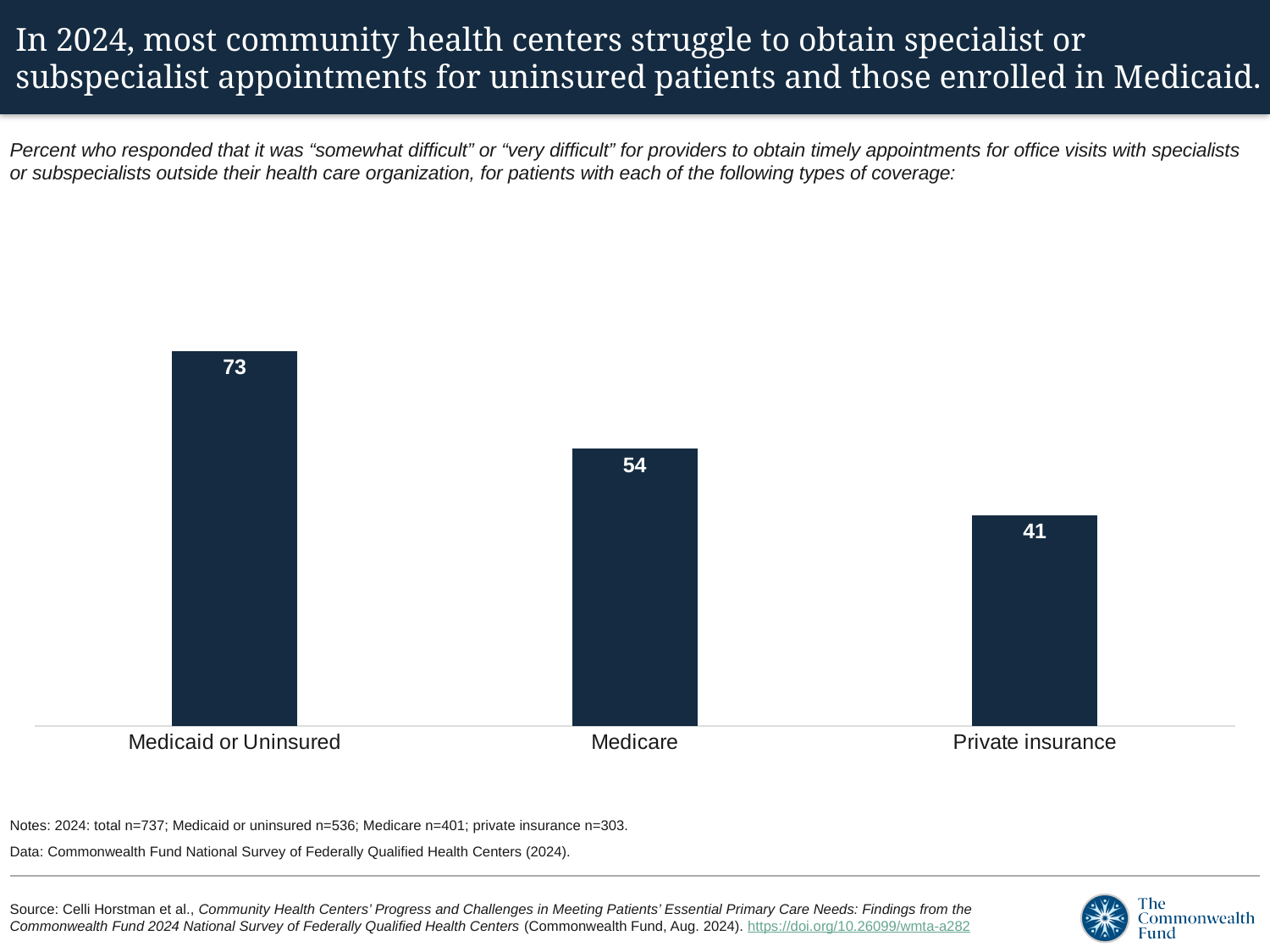
Do the values rise or fall from left to right across the categories? Fall Which is larger, the value for Medicare or the value for Private insurance? Medicare What colour are the bars in the chart? Dark navy blue Which coverage type has the highest value? Medicaid or Uninsured What is the value for Medicare? 54 How many coverage categories are shown in the chart? 3 What is the difference between the values for Medicare and Private insurance? 13 What is the value for Private insurance? 41 What kind of chart is shown on the slide? Bar chart What is the value for Medicaid or Uninsured? 73 Which coverage type has the lowest value? Private insurance What is the difference between the values for Medicaid or Uninsured and Private insurance? 32